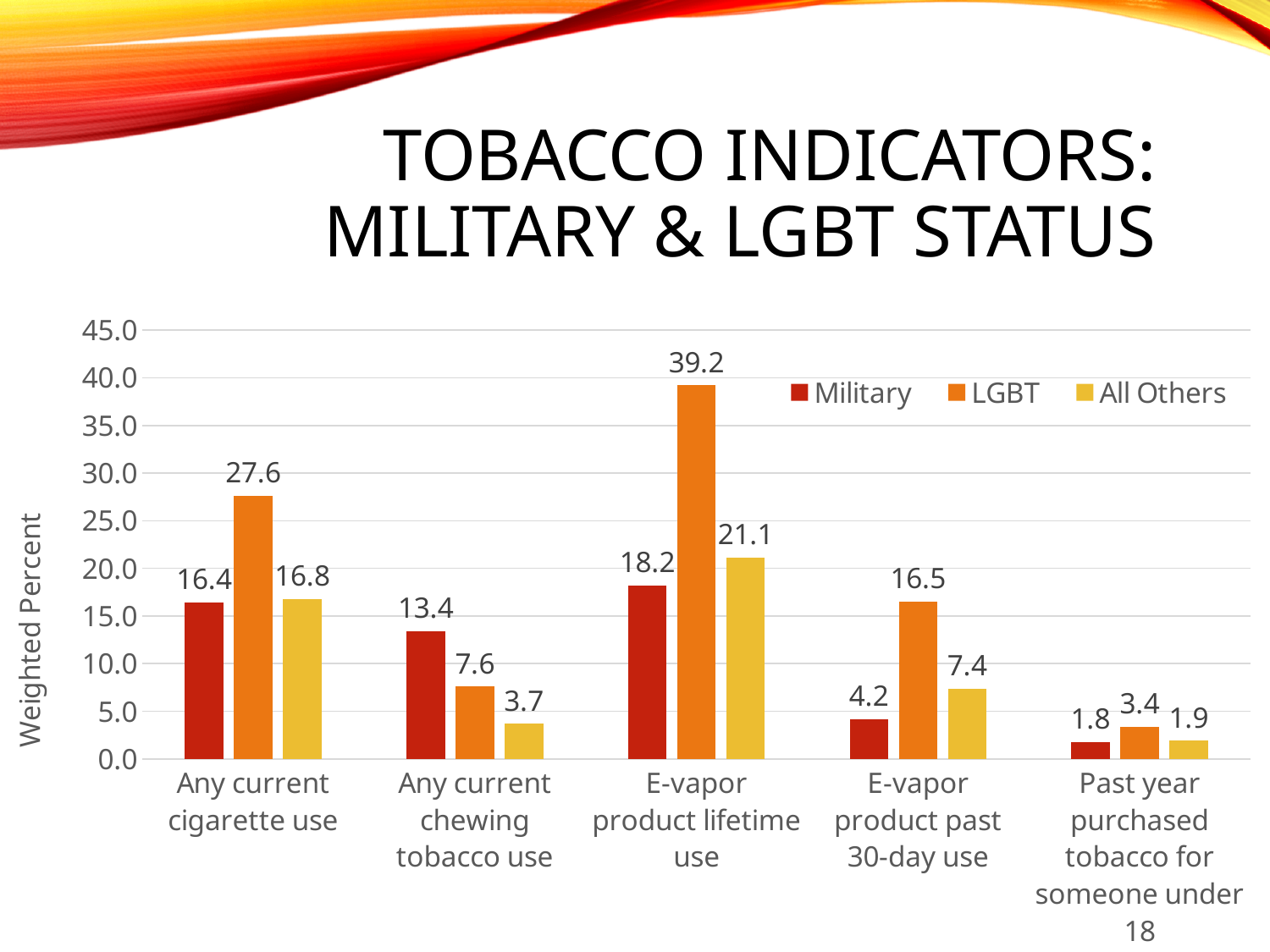
What is the All Others value for E-vapor product past 30-day use? 7.4 How many series does the legend list? 3 Which category has the lowest Military value? Past year purchased tobacco for someone under 18 For Any current chewing tobacco use, which is larger: the Military value or the All Others value? Military Which category has the highest LGBT value? E-vapor product lifetime use What is the Military value for Any current chewing tobacco use? 13.4 What is the difference between the LGBT and Military values for Any current cigarette use? 11.2 What is the label of the vertical axis? Weighted Percent How many categories are shown on the x axis? 5 What is the LGBT value for E-vapor product lifetime use? 39.2 What is the difference between the LGBT and All Others values for E-vapor product lifetime use? 18.1 What kind of chart is shown on the slide? Bar chart